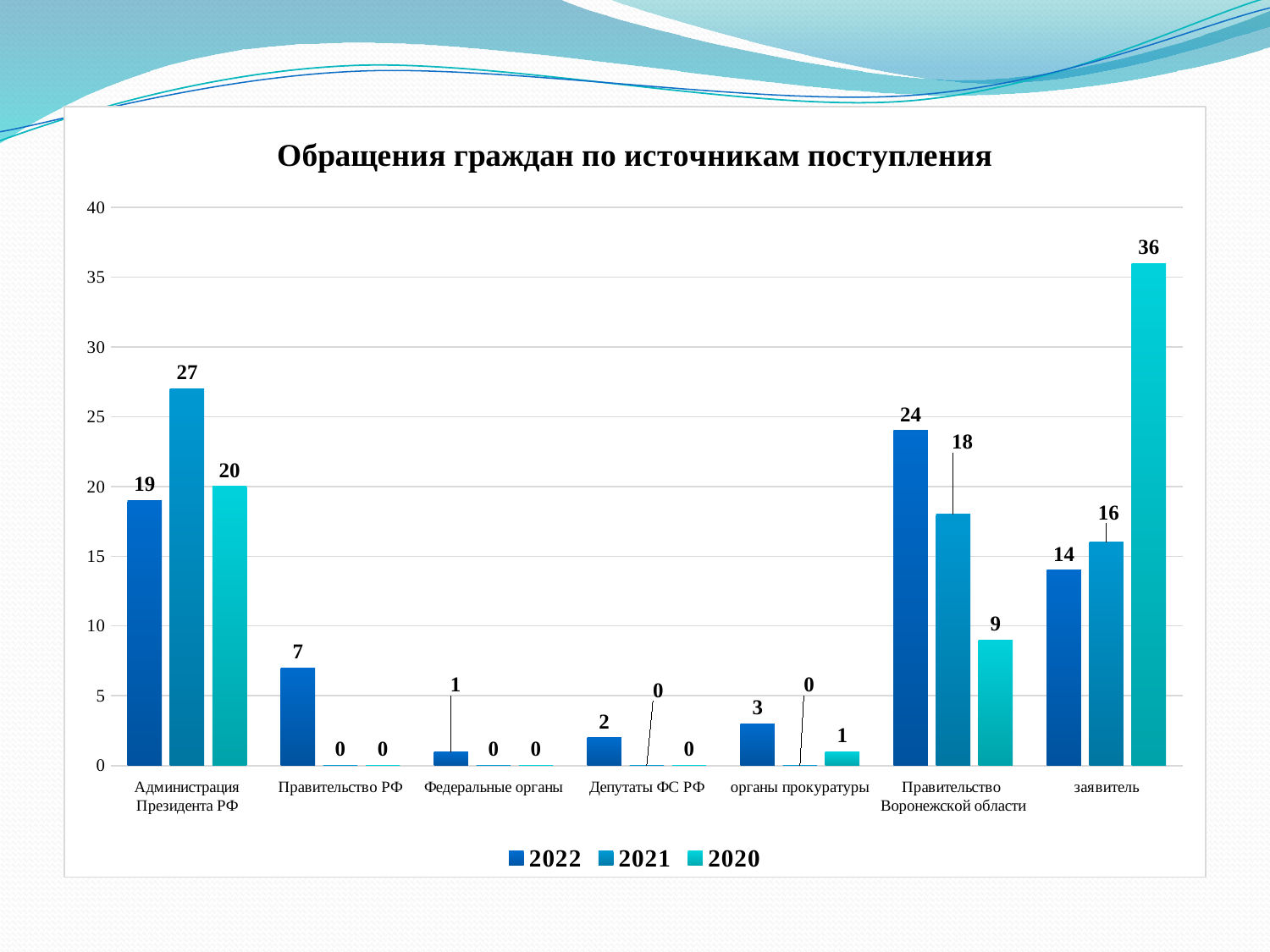
What is the 2021 value for Администрация Президента РФ? 27 How many categories are shown on the x axis? 7 What is the 2022 value for органы прокуратуры? 3 What is the title of the chart? Обращения граждан по источникам поступления Which category has the highest 2022 value? Правительство Воронежской области How many series does the legend list? 3 Which category has the highest 2020 value? заявитель What is the 2020 value for заявитель? 36 Which is larger for заявитель: the 2022 value or the 2021 value? 2021 What type of chart is shown on the slide? bar chart What is the difference between the 2022 and 2020 values for Правительство Воронежской области? 15 What is the 2022 value for Правительство Воронежской области? 24